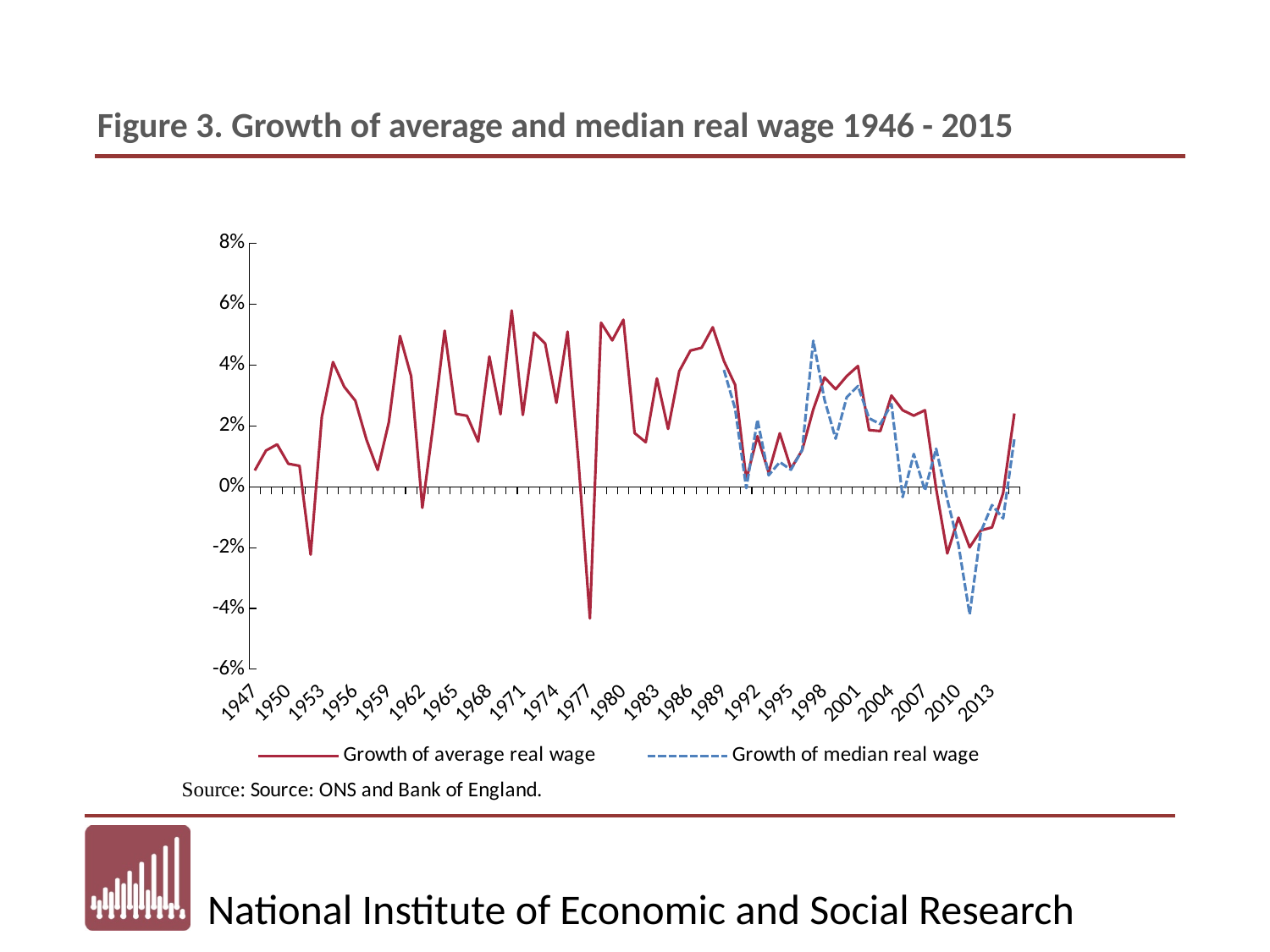
Is the lowest value of the Growth of average real wage series (around 1977) greater or less than -2%? less What are the two series named in the legend? Growth of average real wage; Growth of median real wage Is the lowest value of the Growth of median real wage series (around 2011) greater or less than -2%? less Around 2011, which series shows the lower value: Growth of average real wage or Growth of median real wage? Growth of median real wage Is the highest value of the Growth of average real wage series greater or less than 4%? greater Does the Growth of average real wage series rise or fall between 2007 and 2010? Fall Which series begins earlier on the x axis: Growth of average real wage or Growth of median real wage? Growth of average real wage How many series does the legend list? 2 What kind of chart is shown on the slide? Line chart Does the Growth of average real wage series rise or fall from 2011 to the end of the series? Rise What is the title of the chart? Figure 3. Growth of average and median real wage 1946 - 2015